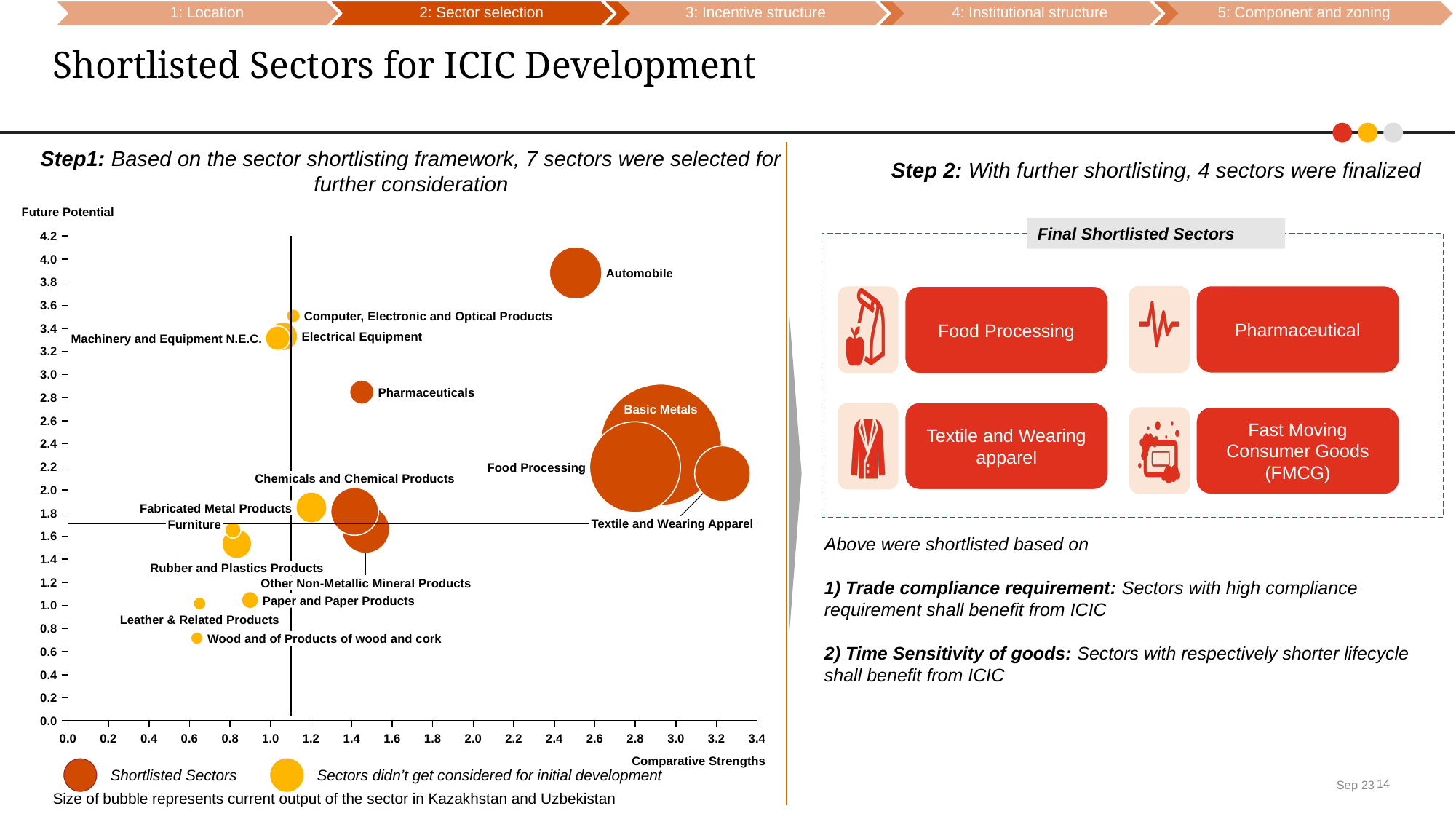
According to the note below the bubble chart, what does the size of a bubble represent? Current output of the sector in Kazakhstan and Uzbekistan Which sector has a higher Comparative Strengths value, Leather & Related Products or Paper and Paper Products? Paper and Paper Products Which sector has the highest Future Potential in the bubble chart? Automobile Is the Comparative Strengths value for Automobile greater or less than 2.0? greater Which sector has the highest Comparative Strengths in the bubble chart? Textile and Wearing Apparel How many sectors are shown as shortlisted (dark orange bubbles) in the bubble chart? 7 Is the Future Potential value for Machinery and Equipment N.E.C. greater or less than 3.0? greater Which sector has the lowest Future Potential in the bubble chart? Wood and of Products of wood and cork What kind of chart is shown on the left side of the slide? bubble chart Is the Future Potential value for Wood and of Products of wood and cork greater or less than 1.0? less Which sector has a higher Future Potential, Pharmaceuticals or Food Processing? Pharmaceuticals